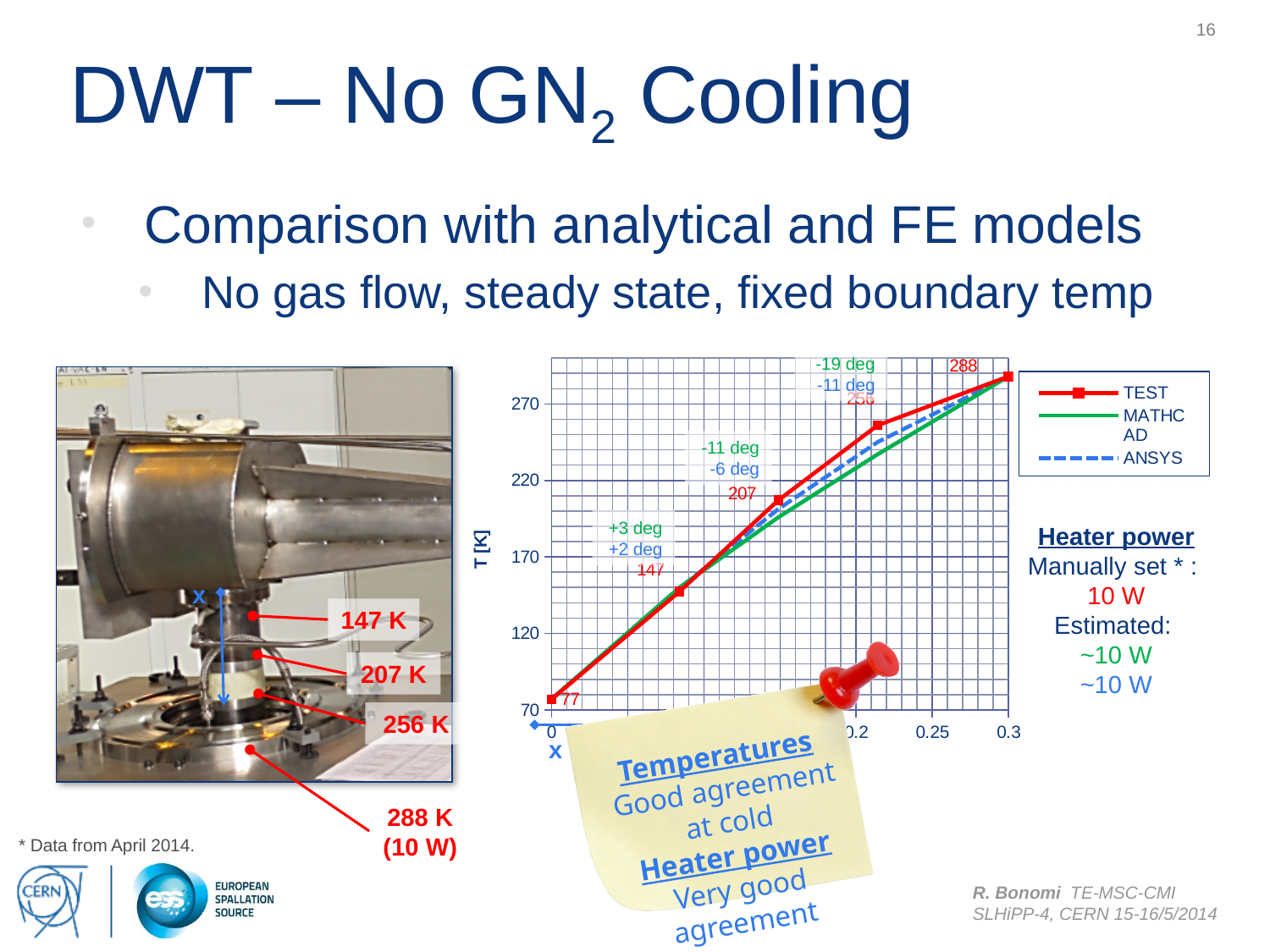
What is the label of the chart's vertical axis? T [K] How many series does the chart legend list? 3 What is the difference between the TEST values labelled 207 and 147? 60 Is the TEST value at x = 0.3 greater or less than 270? greater What is the highest labelled value on the TEST series? 288 Which series are listed in the chart legend? TEST, MATHCAD, ANSYS Do the TEST values rise or fall as x increases along the horizontal axis? rise What kind of chart is shown on the right of the slide? line chart What is the difference between the highest and lowest labelled TEST values (288 and 77)? 211 How many labelled data points does the TEST series have? 5 What is the lowest labelled value on the TEST series? 77 Which is larger, the TEST value labelled 256 or the one labelled 207? 256